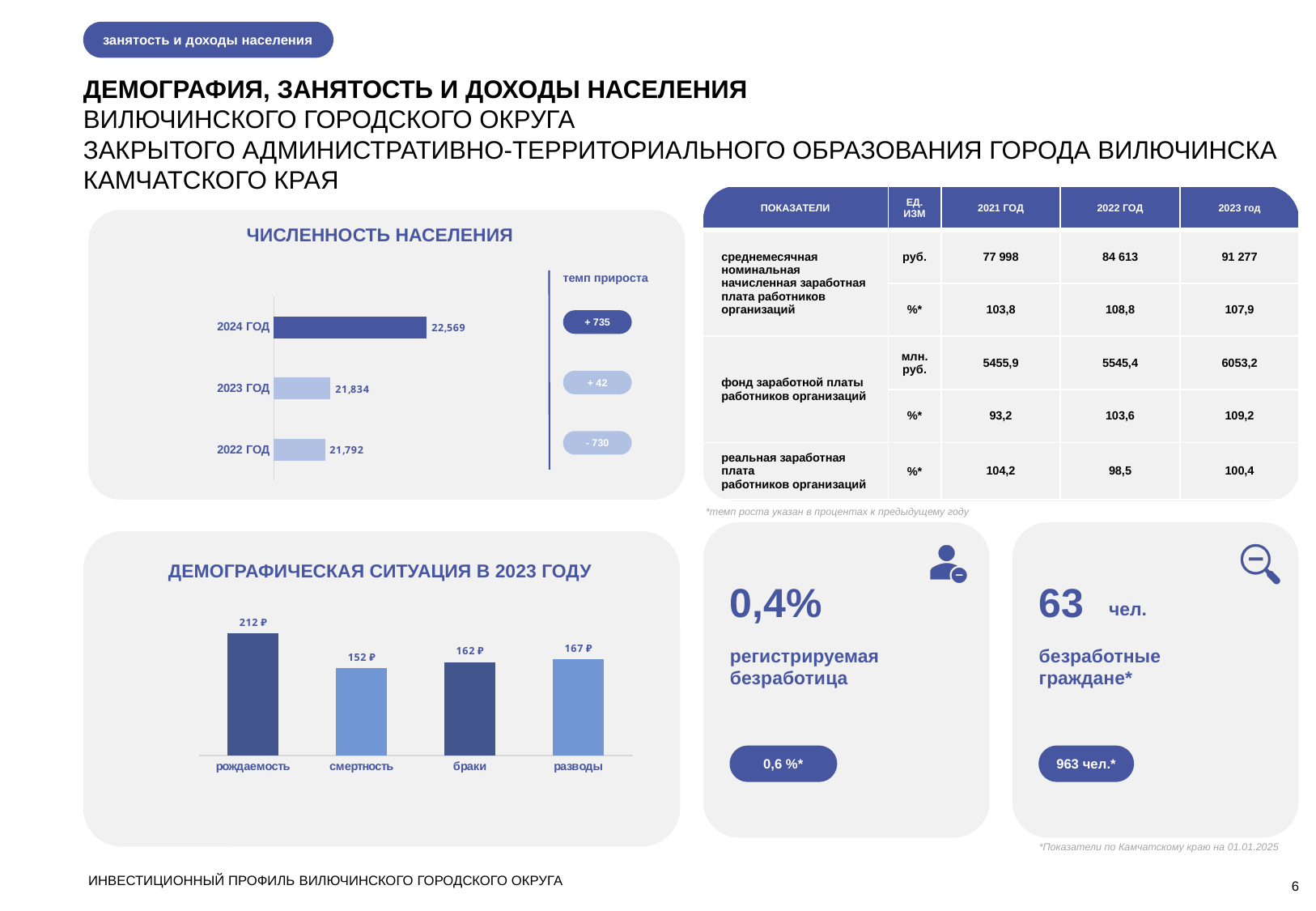
In the 'ЧИСЛЕННОСТЬ НАСЕЛЕНИЯ' chart, what is the value for 2022 ГОД? 21,792 In the 'ДЕМОГРАФИЧЕСКАЯ СИТУАЦИЯ В 2023 ГОДУ' chart, how many categories are shown? 4 In the 'ДЕМОГРАФИЧЕСКАЯ СИТУАЦИЯ В 2023 ГОДУ' chart, which is larger: браки or разводы? разводы In the 'ЧИСЛЕННОСТЬ НАСЕЛЕНИЯ' chart, what is the difference between the values for 2024 ГОД and 2023 ГОД? 735 In the 'ДЕМОГРАФИЧЕСКАЯ СИТУАЦИЯ В 2023 ГОДУ' chart, which category has the lowest value? смертность What kind of chart is 'ЧИСЛЕННОСТЬ НАСЕЛЕНИЯ'? Bar chart In the 'ДЕМОГРАФИЧЕСКАЯ СИТУАЦИЯ В 2023 ГОДУ' chart, what is the value for разводы? 167 ₽ In the 'ЧИСЛЕННОСТЬ НАСЕЛЕНИЯ' chart, how many years are shown? 3 In the 'ЧИСЛЕННОСТЬ НАСЕЛЕНИЯ' chart, what is the value for 2024 ГОД? 22,569 In the 'ЧИСЛЕННОСТЬ НАСЕЛЕНИЯ' chart, which year has the highest value? 2024 ГОД In the 'ДЕМОГРАФИЧЕСКАЯ СИТУАЦИЯ В 2023 ГОДУ' chart, what is the difference between рождаемость and смертность? 60 ₽ In the 'ДЕМОГРАФИЧЕСКАЯ СИТУАЦИЯ В 2023 ГОДУ' chart, what is the value for рождаемость? 212 ₽